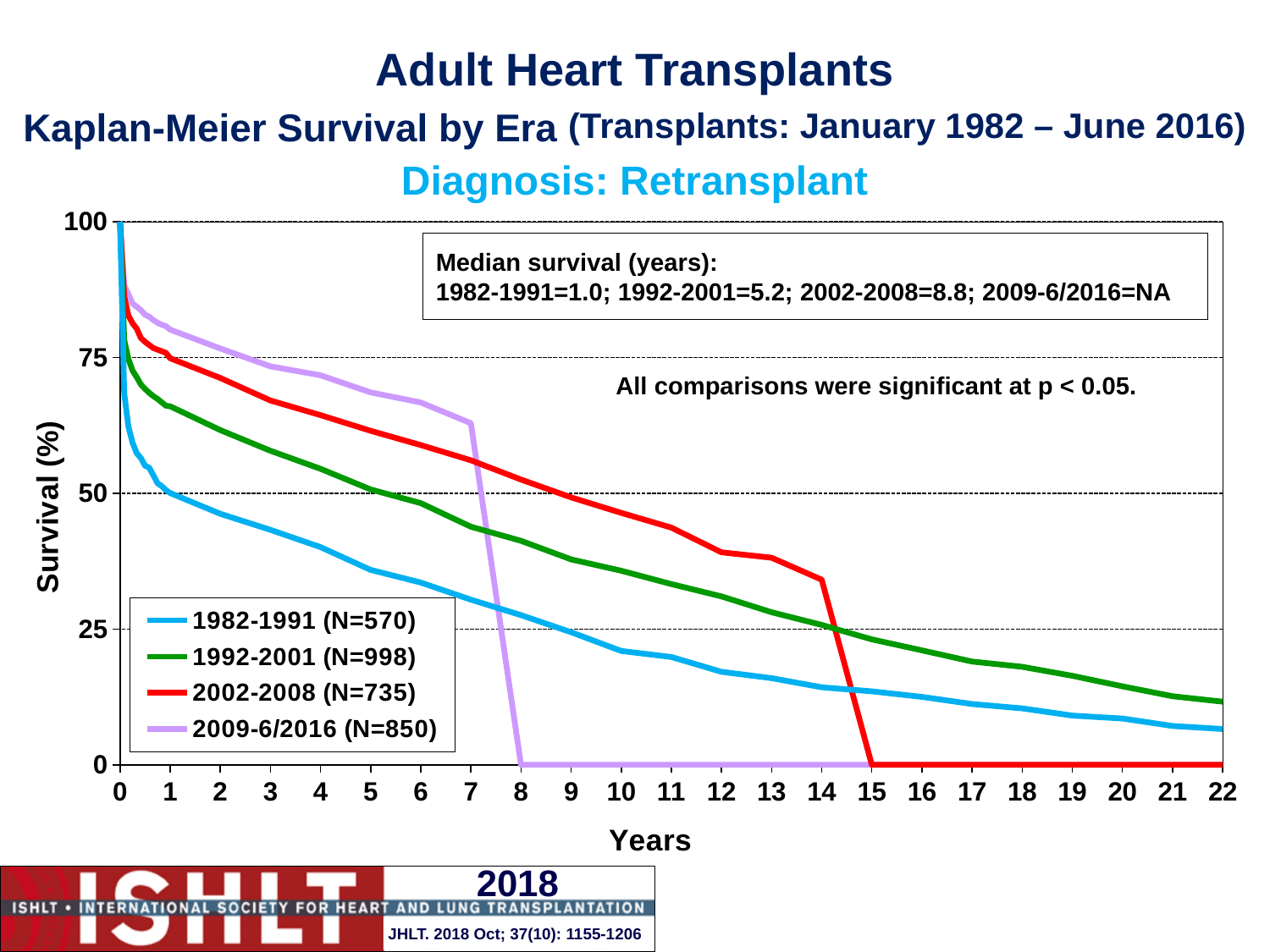
Is the survival for the 1982-1991 era at 10 years greater or less than 25%? less How many eras (series) does the legend list? 4 What type of chart is shown on the slide? Line chart What is the difference in median survival (years) between the 2002-2008 and 1992-2001 eras? 3.6 What is the median survival in years for the 1992-2001 era? 5.2 Do the survival curves rise or fall as years increase? fall What is the N for the 1992-2001 era shown in the legend? 998 What is the median survival given for the 2009-6/2016 era? NA What is the median survival in years for the 2002-2008 era? 8.8 Among the eras with a reported median survival, which has the highest median survival? 2002-2008 What is the median survival in years for the 1982-1991 era? 1.0 At 10 years, which era has higher survival: 2002-2008 or 1982-1991? 2002-2008